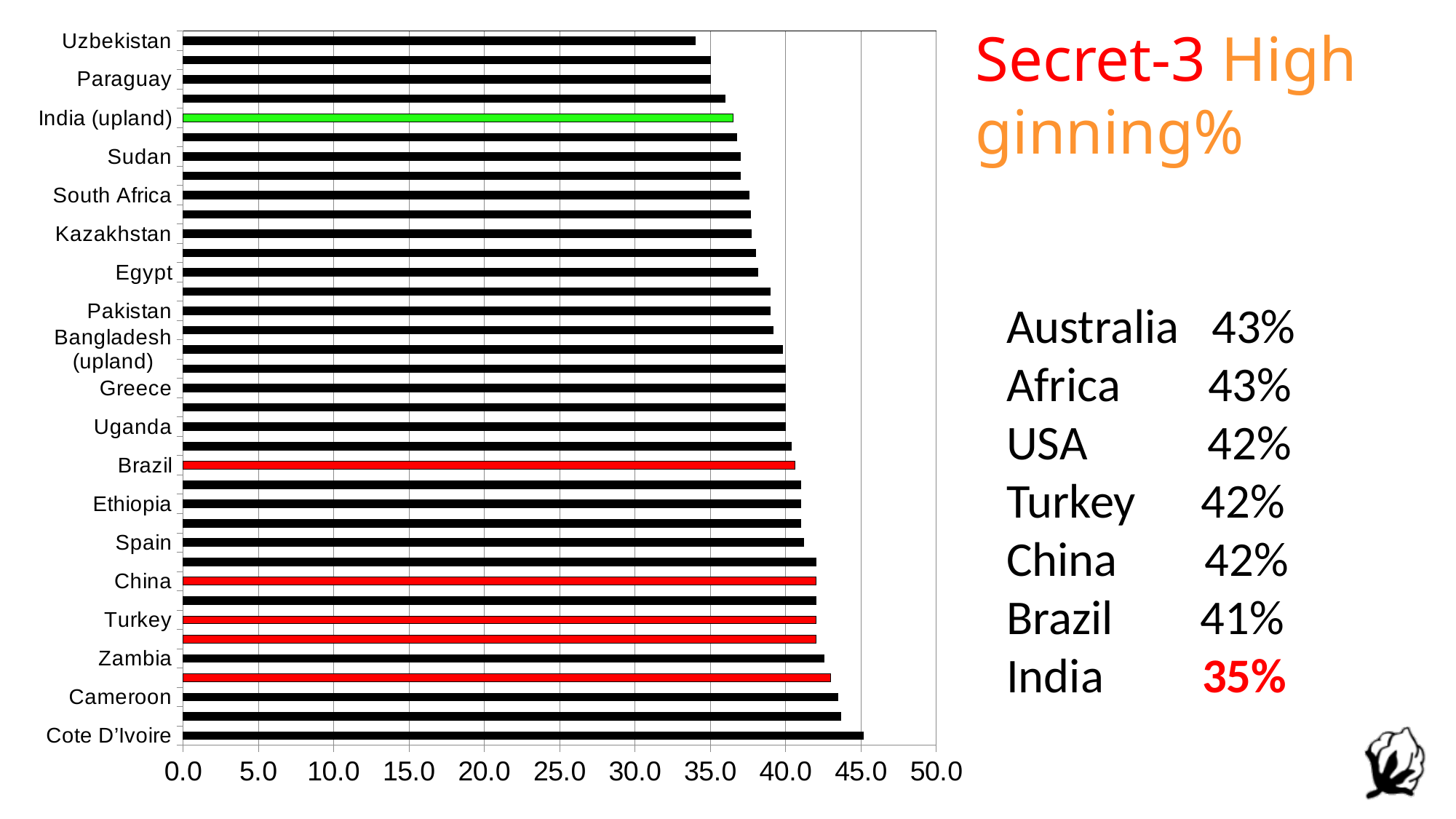
Is the value for Cameroon greater or less than 40.0? greater Is the value for Uzbekistan greater or less than 40.0? less Which labelled country has the longest bar in the chart? Cote D'Ivoire Is the value for Paraguay greater or less than 40.0? less Do the bars get longer or shorter going from the top of the chart to the bottom? longer Which has the larger value, Cote D'Ivoire or Uzbekistan? Cote D'Ivoire Which has the larger value, Sudan or China? China Which labelled country has the shortest bar in the chart? Uzbekistan What kind of chart is shown on the slide? bar chart What colour is the bar for India (upland)? green